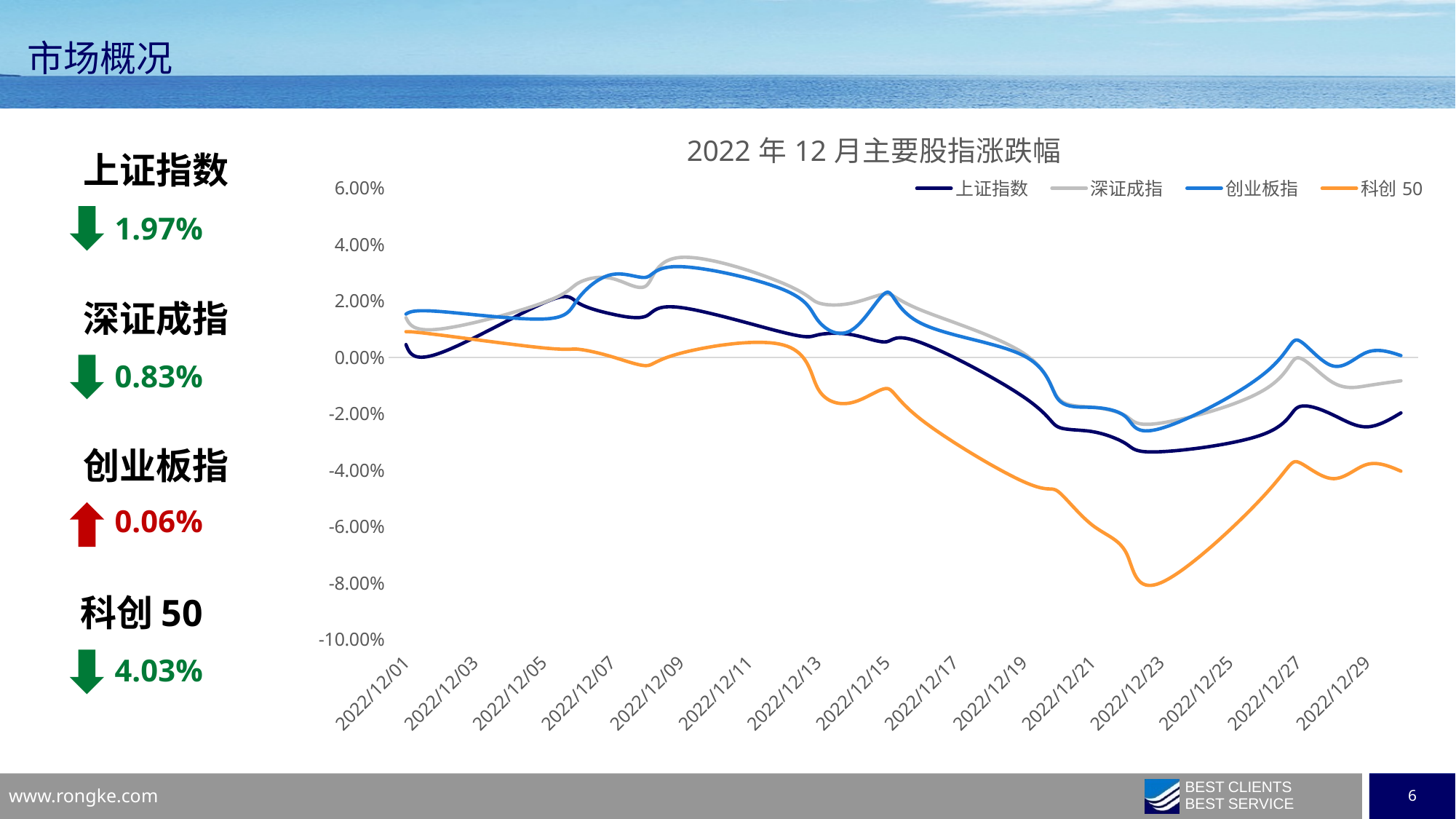
What kind of chart is shown on the slide? line chart Which series is drawn in orange in the chart? 科创 50 Does the 科创 50 line rise or fall between 2022/12/15 and 2022/12/23? fall Is the value for 深证成指 at 2022/12/09 greater or less than 2.00%? greater Which series has the lowest value at 2022/12/23? 科创 50 At 2022/12/29, which series is higher: 创业板指 or 科创 50? 创业板指 How many series does the chart legend list? 4 What is the title of the chart? 2022 年 12 月主要股指涨跌幅 Which series has the lowest value at 2022/12/29? 科创 50 Is the value for 上证指数 at 2022/12/23 greater or less than -2.00%? less How many date labels are shown on the x axis? 15 Is the value for 科创 50 at 2022/12/23 greater or less than -6.00%? less